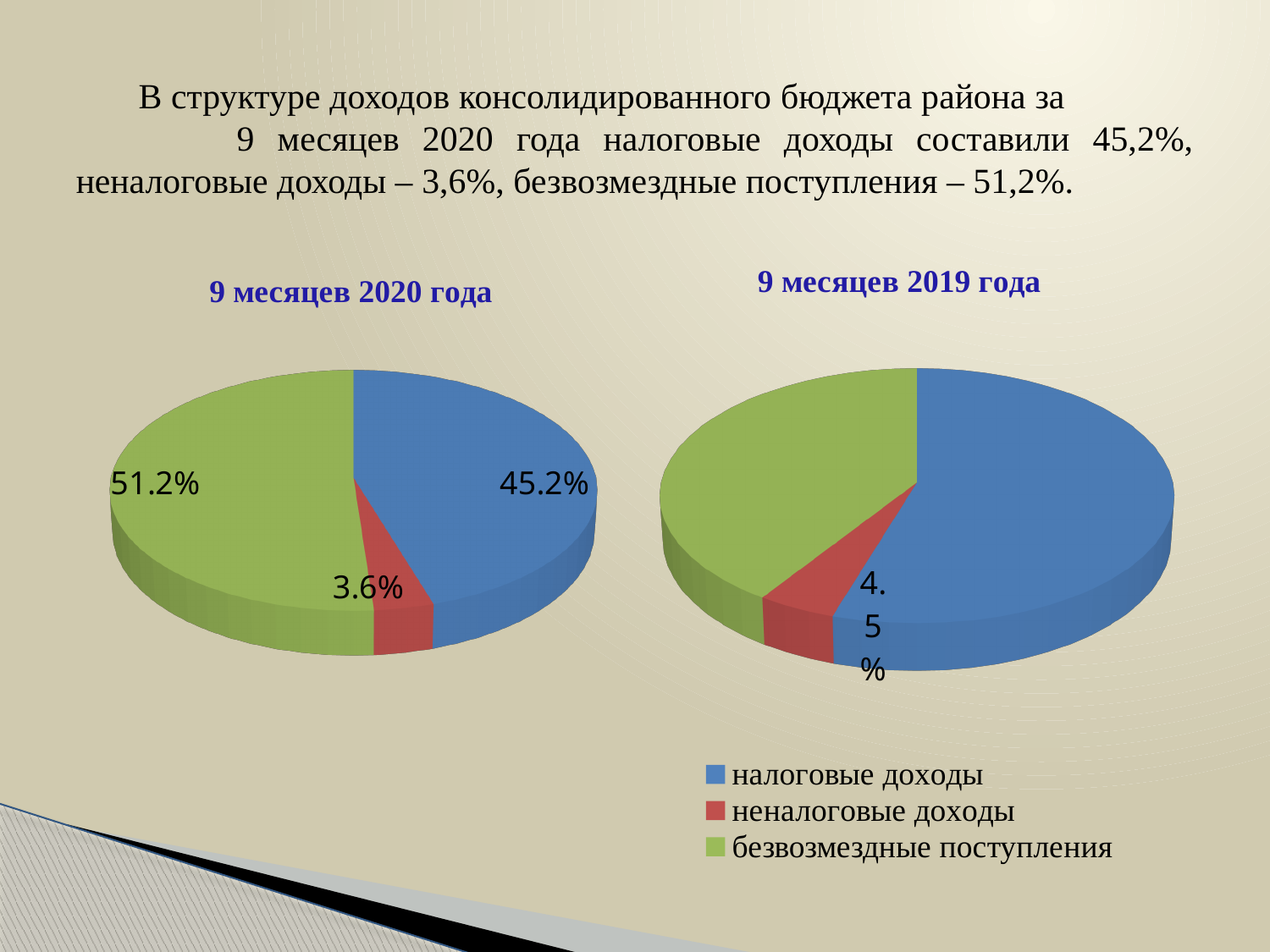
Which colour represents неналоговые доходы in the legend? red In the pie chart titled "9 месяцев 2020 года", by how many percentage points does безвозмездные поступления exceed налоговые доходы? 6 percentage points In the pie chart titled "9 месяцев 2020 года", what share is shown for налоговые доходы? 45.2% What type of chart is used for "9 месяцев 2020 года"? pie chart How many categories does the legend list for the pie charts? 3 In the pie chart titled "9 месяцев 2020 года", which category has the largest slice? безвозмездные поступления In the pie chart titled "9 месяцев 2020 года", which category has the smallest slice? неналоговые доходы In the pie chart titled "9 месяцев 2019 года", which is larger: налоговые доходы or безвозмездные поступления? налоговые доходы In the pie chart titled "9 месяцев 2020 года", what share is shown for неналоговые доходы? 3.6% In the pie chart titled "9 месяцев 2020 года", what share is shown for безвозмездные поступления? 51.2% In the pie chart titled "9 месяцев 2019 года", what share is labelled for неналоговые доходы? 4.5% In the pie chart titled "9 месяцев 2019 года", which category has the smallest slice? неналоговые доходы